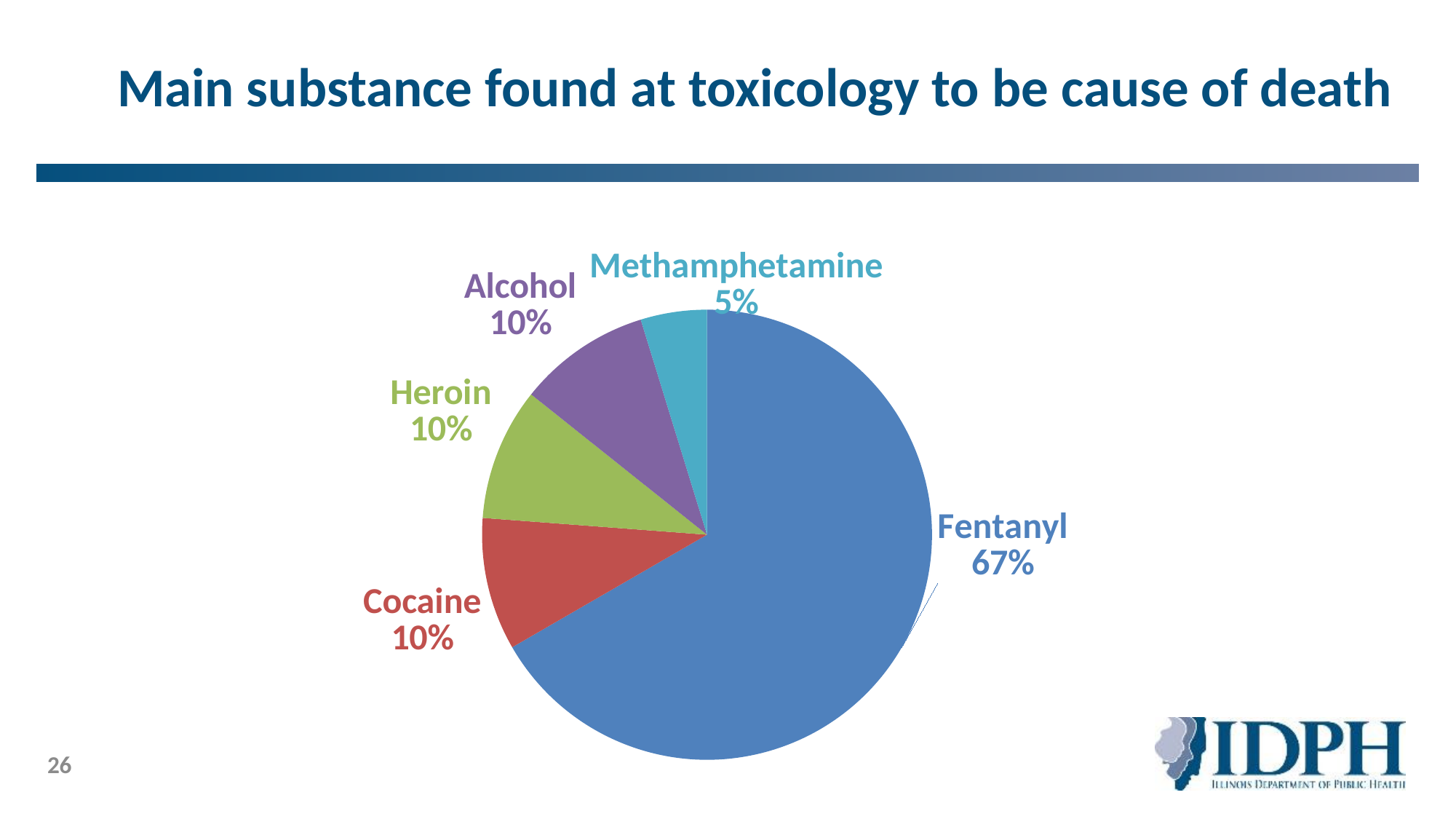
What is the title of the slide? Main substance found at toxicology to be cause of death What percentage is shown for Cocaine? 10% Which substance has the largest slice of the pie? Fentanyl What is the difference in percentage points between Fentanyl and Heroin? 57 What kind of chart is shown on the slide? Pie chart What is the difference in percentage points between Alcohol and Methamphetamine? 5 Which is larger, the share for Fentanyl or the share for Cocaine? Fentanyl What colour is the Heroin slice? Green How many substances are shown in the pie chart? 5 What percentage is shown for Methamphetamine? 5% What share of the pie does Fentanyl account for? 67% Which substance has the smallest slice of the pie? Methamphetamine